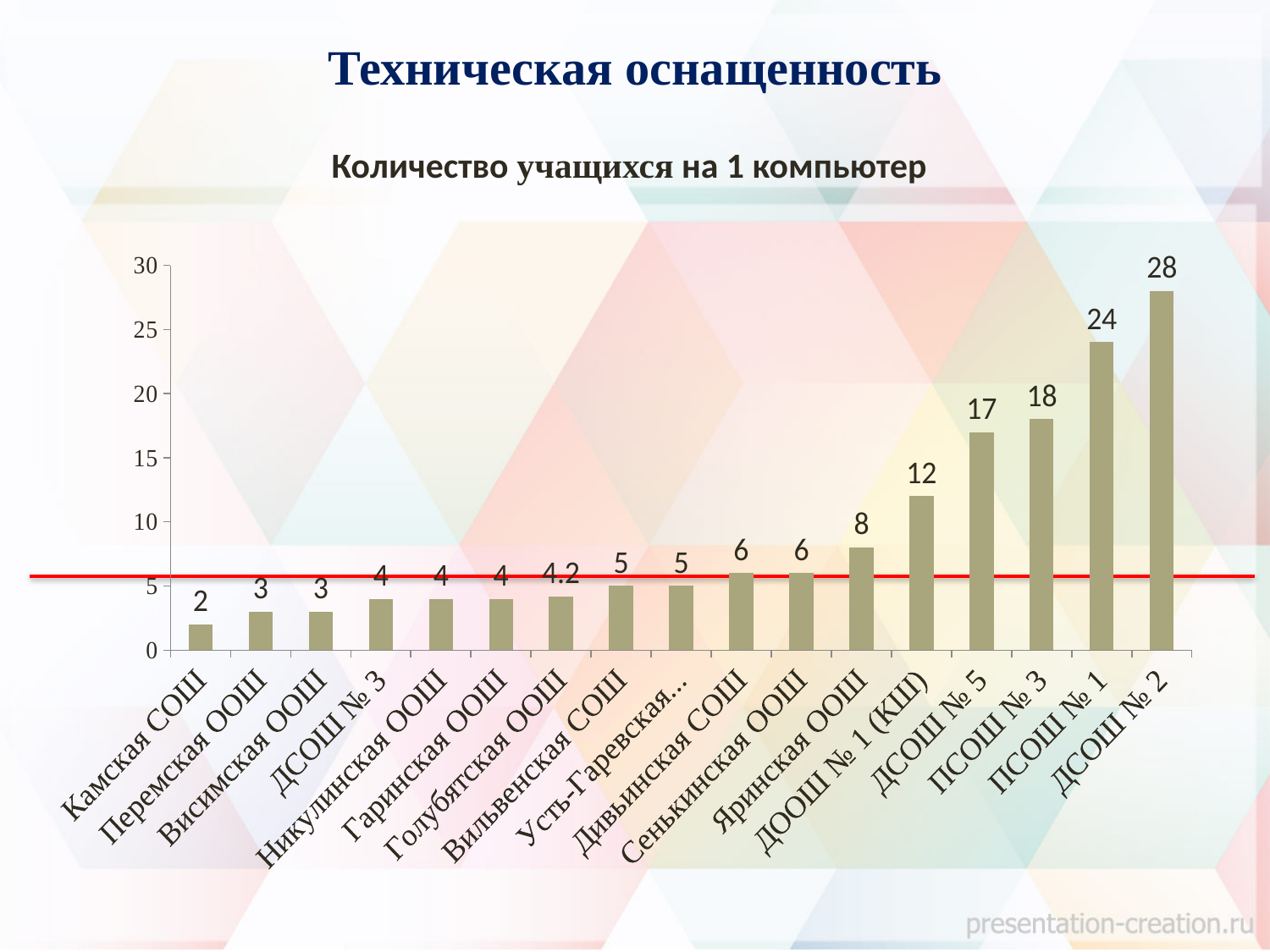
What is the difference between the values for ПСОШ № 3 and ДСОШ № 5? 1 How many categories are shown on the x axis? 17 Which is larger, the value for ДСОШ № 5 or the value for ДООШ № 1 (КШ)? ДСОШ № 5 What is the value for ДСОШ № 2? 28 What kind of chart is shown on the slide? Bar chart What is the difference between the values for ДСОШ № 2 and ПСОШ № 1? 4 Which category has the lowest value? Камская СОШ What is the title of the chart? Количество учащихся на 1 компьютер Which category has the highest value? ДСОШ № 2 What is the value for Голубятская ООШ? 4.2 What is the value for Яринская ООШ? 8 What is the value for ДООШ № 1 (КШ)? 12